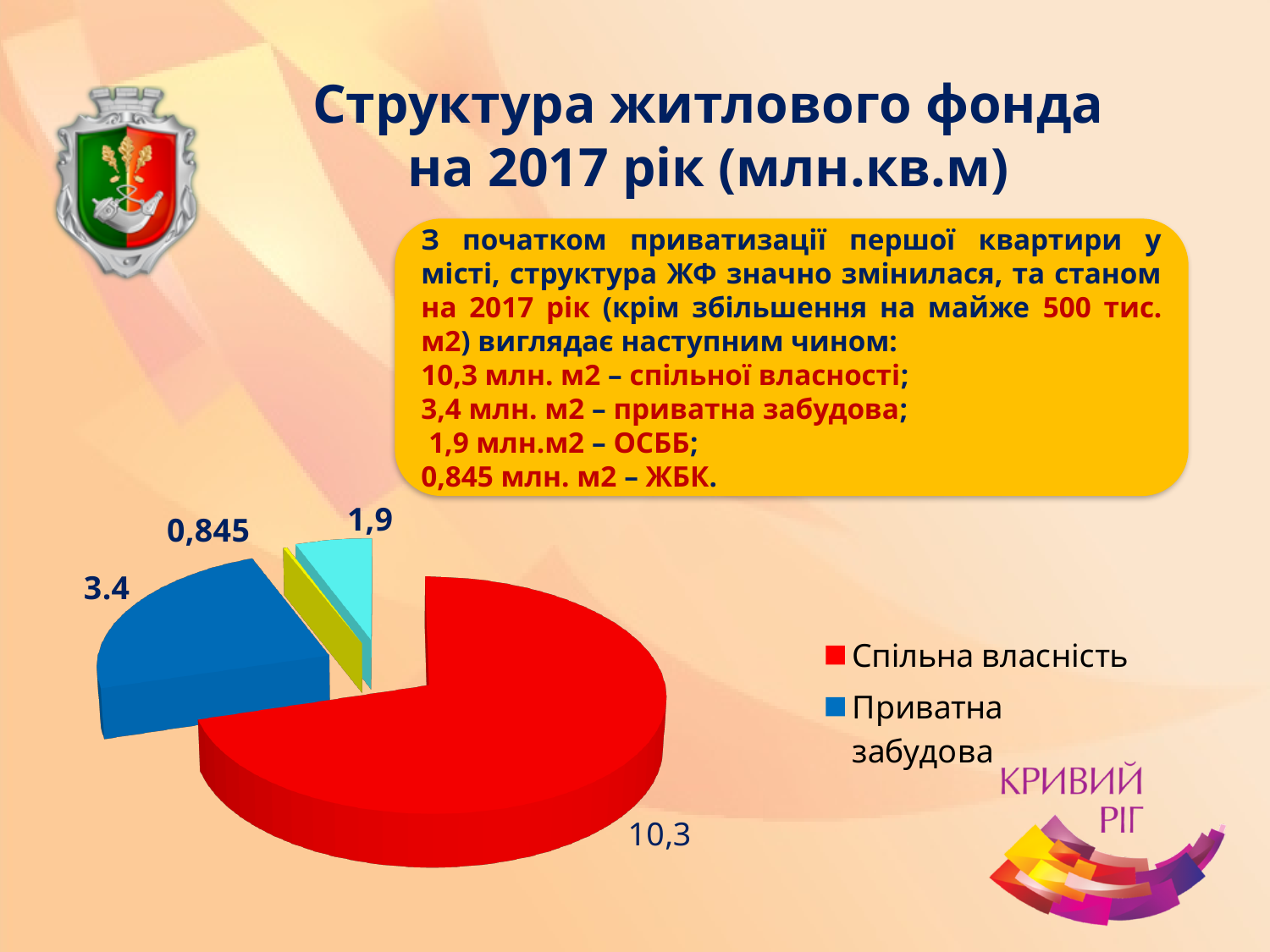
What is the title of the slide containing the pie chart? Структура житлового фонда на 2017 рік (млн.кв.м) What value is labelled on the blue slice (Приватна забудова)? 3.4 What value is labelled on the yellow slice of the pie chart? 0,845 Which legend entry corresponds to the red slice? Спільна власність How many slices does the pie chart have? 4 Which slice of the pie chart has the smallest value? the yellow slice (0,845) What value is labelled on the cyan slice of the pie chart? 1,9 Which slice of the pie chart has the largest value? Спільна власність (10,3) What kind of chart is shown on the slide? pie chart What value is labelled on the red slice (Спільна власність)? 10,3 What is the difference between the red slice value (10,3) and the cyan slice value (1,9)? 8,4 Which is larger, the blue slice (Приватна забудова) or the cyan slice? the blue slice (Приватна забудова)